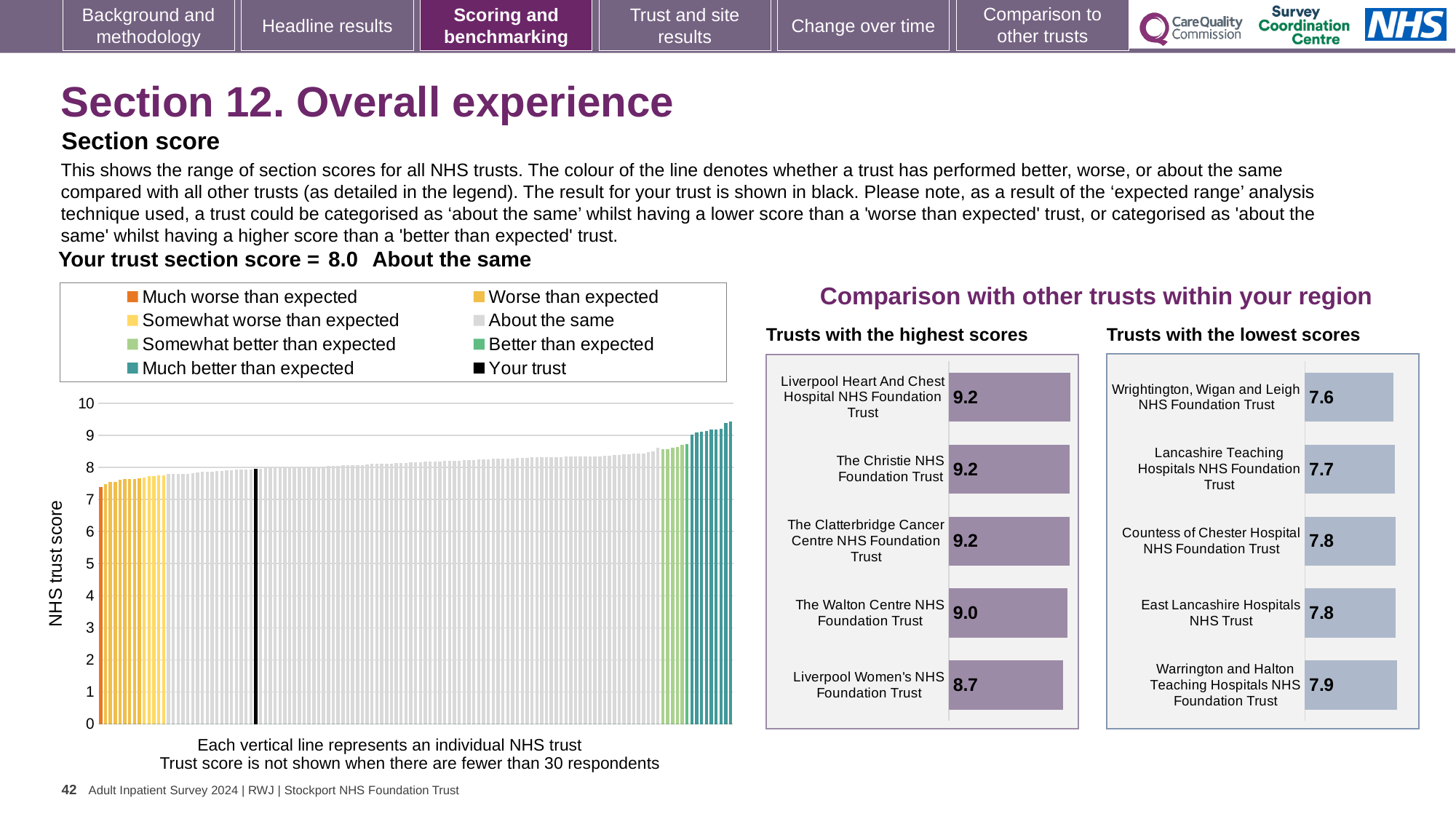
In the 'Trusts with the lowest scores' chart, what is the score for Wrightington, Wigan and Leigh NHS Foundation Trust? 7.6 How many entries does the legend of the large chart on the left list? 8 In the 'Trusts with the lowest scores' chart, which has the higher score: Warrington and Halton Teaching Hospitals NHS Foundation Trust or Lancashire Teaching Hospitals NHS Foundation Trust? Warrington and Halton Teaching Hospitals NHS Foundation Trust In the 'Trusts with the highest scores' chart, what is the score for The Walton Centre NHS Foundation Trust? 9.0 What is the y-axis label of the large chart on the left? NHS trust score In the 'Trusts with the highest scores' chart, what is the difference between the scores of Liverpool Heart And Chest Hospital NHS Foundation Trust and Liverpool Women's NHS Foundation Trust? 0.5 In the 'Trusts with the lowest scores' chart, which trust has the lowest score? Wrightington, Wigan and Leigh NHS Foundation Trust According to the slide, what is your trust's section score for Overall experience? 8.0 In the 'Trusts with the lowest scores' chart, what is the score for Countess of Chester Hospital NHS Foundation Trust? 7.8 In the large chart on the left, do the trust scores rise or fall from left to right? Rise What kind of chart is the large chart on the left showing NHS trust scores? Bar chart How many trusts are shown in the 'Trusts with the highest scores' chart? 5